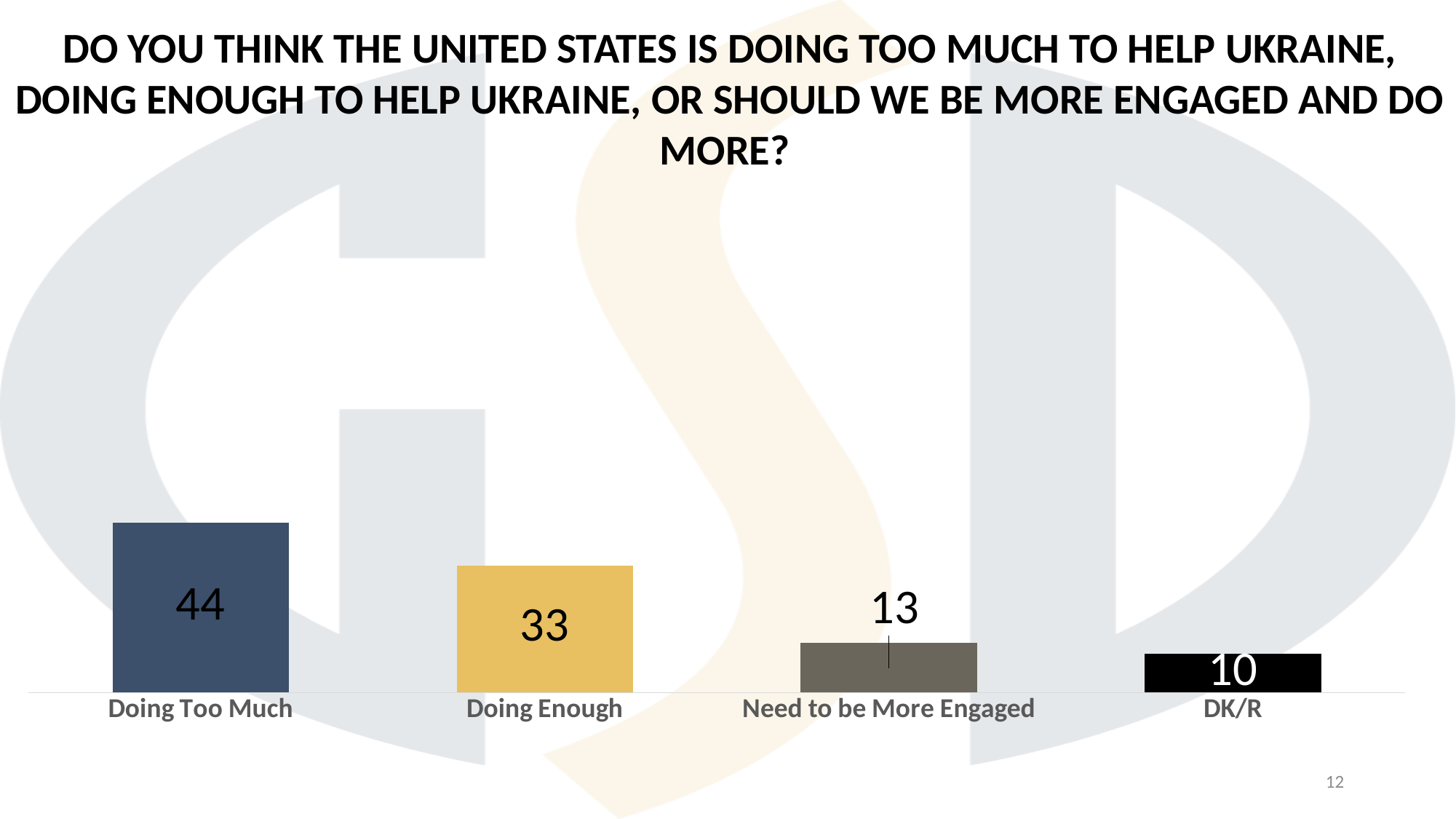
How many categories are shown in the chart? 4 What is the difference between the values for Need to be More Engaged and DK/R? 3 What is the value for Doing Enough? 33 What is the value for DK/R? 10 What is the value for Doing Too Much? 44 What kind of chart is shown on the slide? Bar chart What is the value for Need to be More Engaged? 13 Which category has the highest value? Doing Too Much What colour is the bar for Doing Enough? Yellow Which category has the lowest value? DK/R Which is larger, the value for Doing Enough or the value for Need to be More Engaged? Doing Enough What is the difference between the values for Doing Too Much and Doing Enough? 11